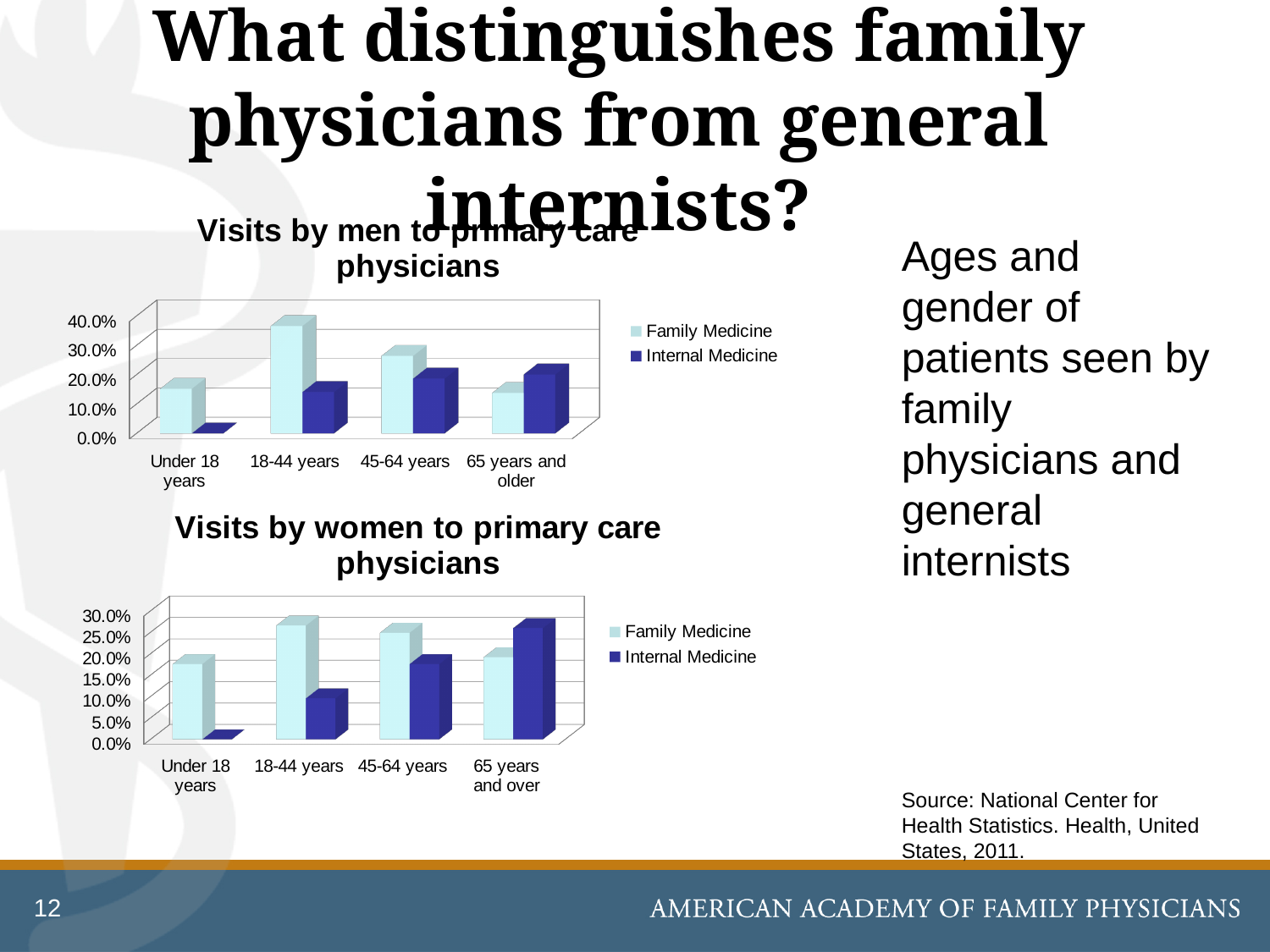
How many age groups are shown in the 'Visits by men to primary care physicians' chart? 4 In the 'Visits by women to primary care physicians' chart, is the Internal Medicine value for 18-44 years greater or less than 15.0%? less In the 'Visits by men to primary care physicians' chart, is the Internal Medicine value for Under 18 years greater or less than 10.0%? less How many series does the legend of the 'Visits by men to primary care physicians' chart list? 2 In the 'Visits by men to primary care physicians' chart, which age group has the lowest Internal Medicine value? Under 18 years In the 'Visits by men to primary care physicians' chart, is the Family Medicine value for 18-44 years greater or less than 30.0%? greater In the 'Visits by women to primary care physicians' chart, which series has the larger value for 45-64 years, Family Medicine or Internal Medicine? Family Medicine In the 'Visits by men to primary care physicians' chart, which series has the larger value for 65 years and older, Family Medicine or Internal Medicine? Internal Medicine In the 'Visits by women to primary care physicians' chart, which age group has the highest Internal Medicine value? 65 years and over In the 'Visits by men to primary care physicians' chart, which age group has the highest Family Medicine value? 18-44 years In the 'Visits by women to primary care physicians' chart, do the Internal Medicine values rise or fall as the age groups get older? rise What kind of chart is the 'Visits by women to primary care physicians' chart? bar chart